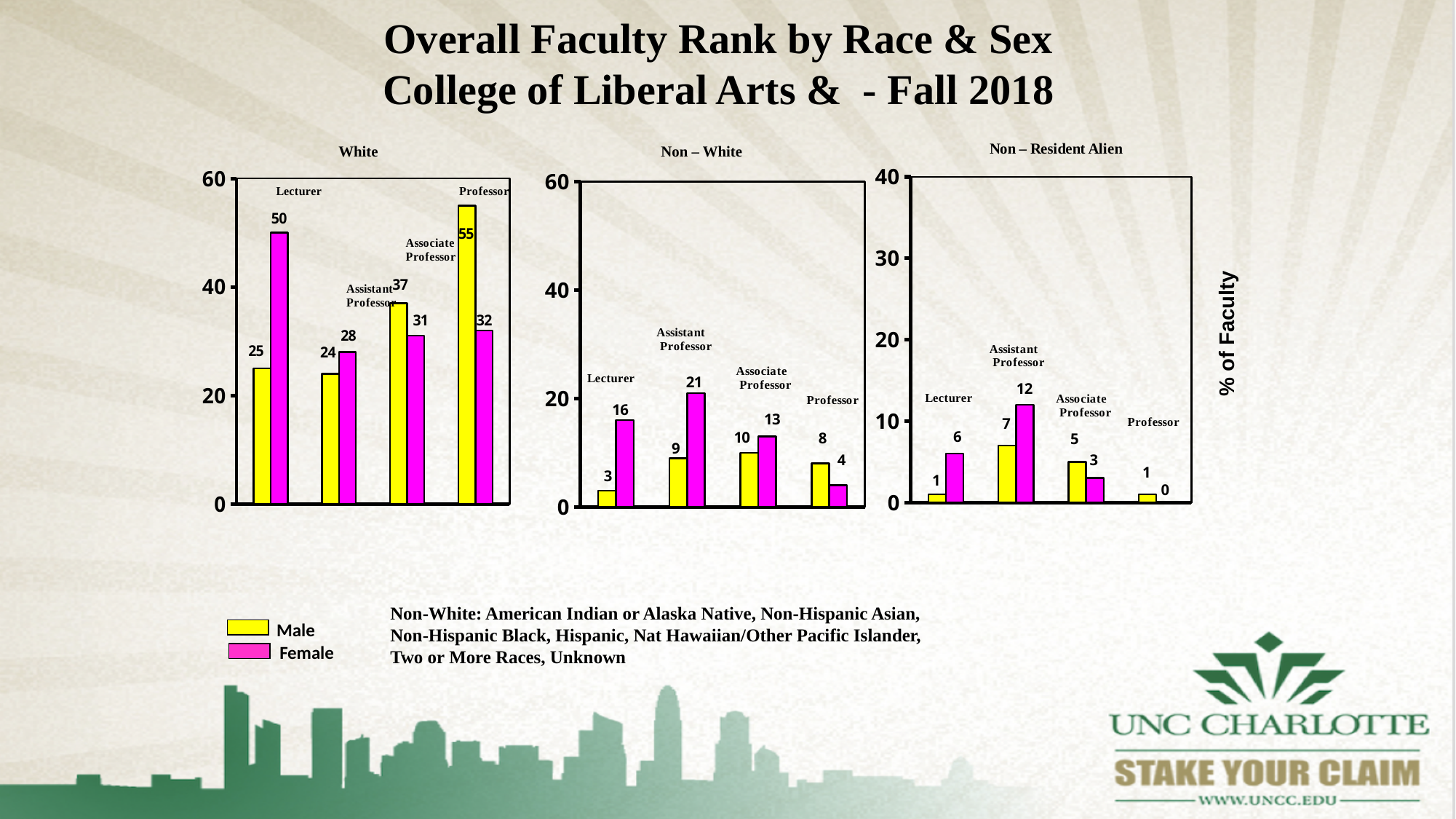
What type of chart is the Non – White chart? Bar chart How many rank categories are shown in the Non – Resident Alien chart? 4 In the Non – White chart, which is larger for Professor, the Male value or the Female value? Male In the Non – Resident Alien chart, which rank has the lowest Female value? Professor In the Non – White chart, which rank has the highest Female value? Assistant Professor In the Non – Resident Alien chart, what is the value for Male Assistant Professor? 7 In the White chart, what is the value for Female Lecturer? 50 How many series does the legend list? 2 In the White chart, what is the difference between the Male and Female values for Professor? 23 In the White chart, what is the value for Male Professor? 55 In the White chart, is the Male Associate Professor value greater or less than 40? less In the Non – White chart, what is the value for Female Assistant Professor? 21